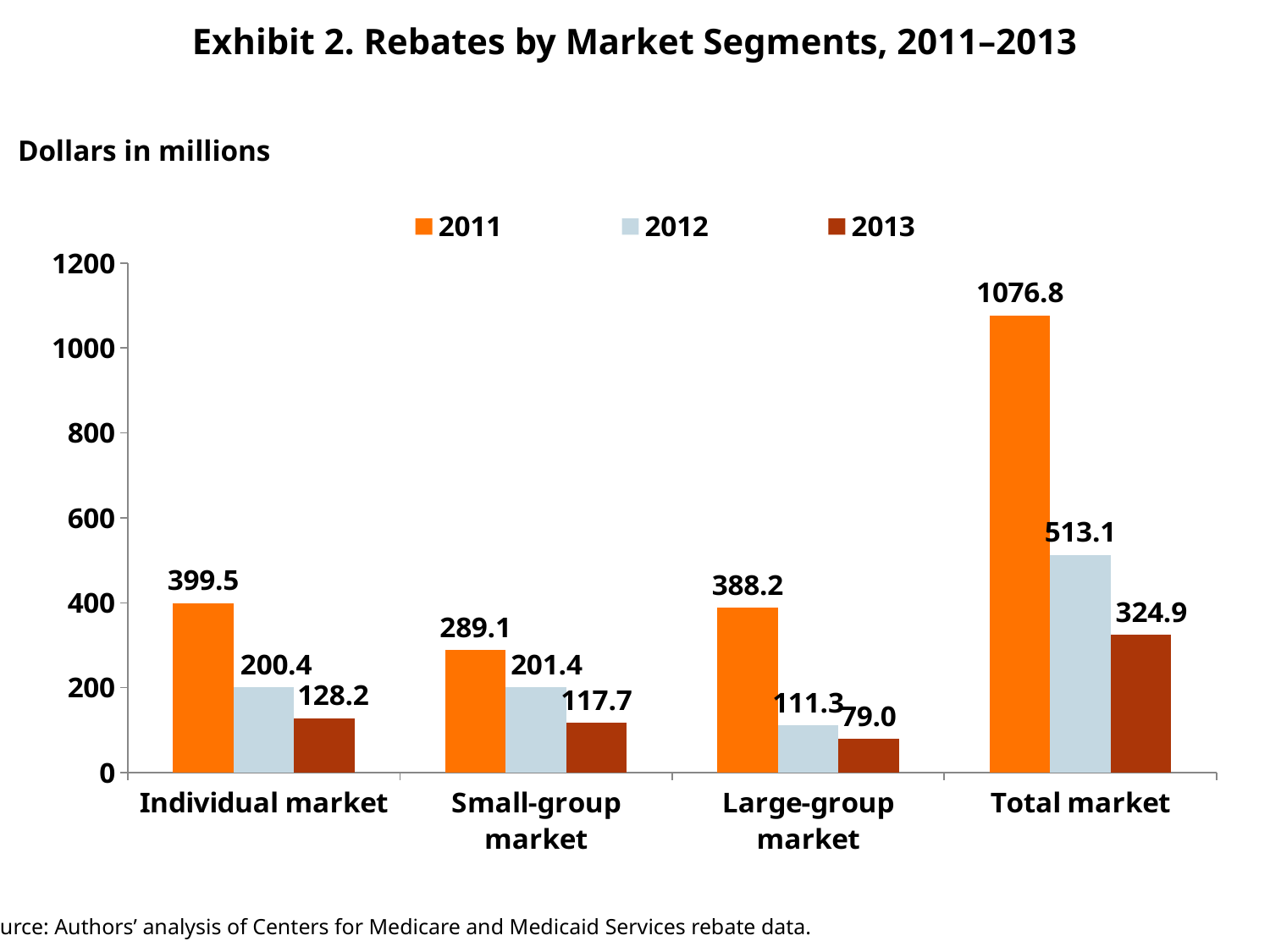
Is the 2011 rebate value for the Total market greater or less than 1000? greater Which is larger: the 2012 rebate value for the Individual market or the 2012 rebate value for the Small-group market? Small-group market Which market segment had the highest rebate value in 2011? Total market What was the rebate value for the Large-group market in 2013? 79.0 What was the rebate value for the Total market in 2012? 513.1 How many market segments are shown on the x axis? 4 Do the rebate values for the Small-group market rise or fall from 2011 to 2013? Fall How many series does the legend list? 3 What kind of chart is shown on the slide? Bar chart What was the rebate value for the Individual market in 2011? 399.5 Excluding the Total market, which market segment had the lowest rebate value in 2013? Large-group market What is the difference between the 2011 and 2013 rebate values for the Total market? 751.9